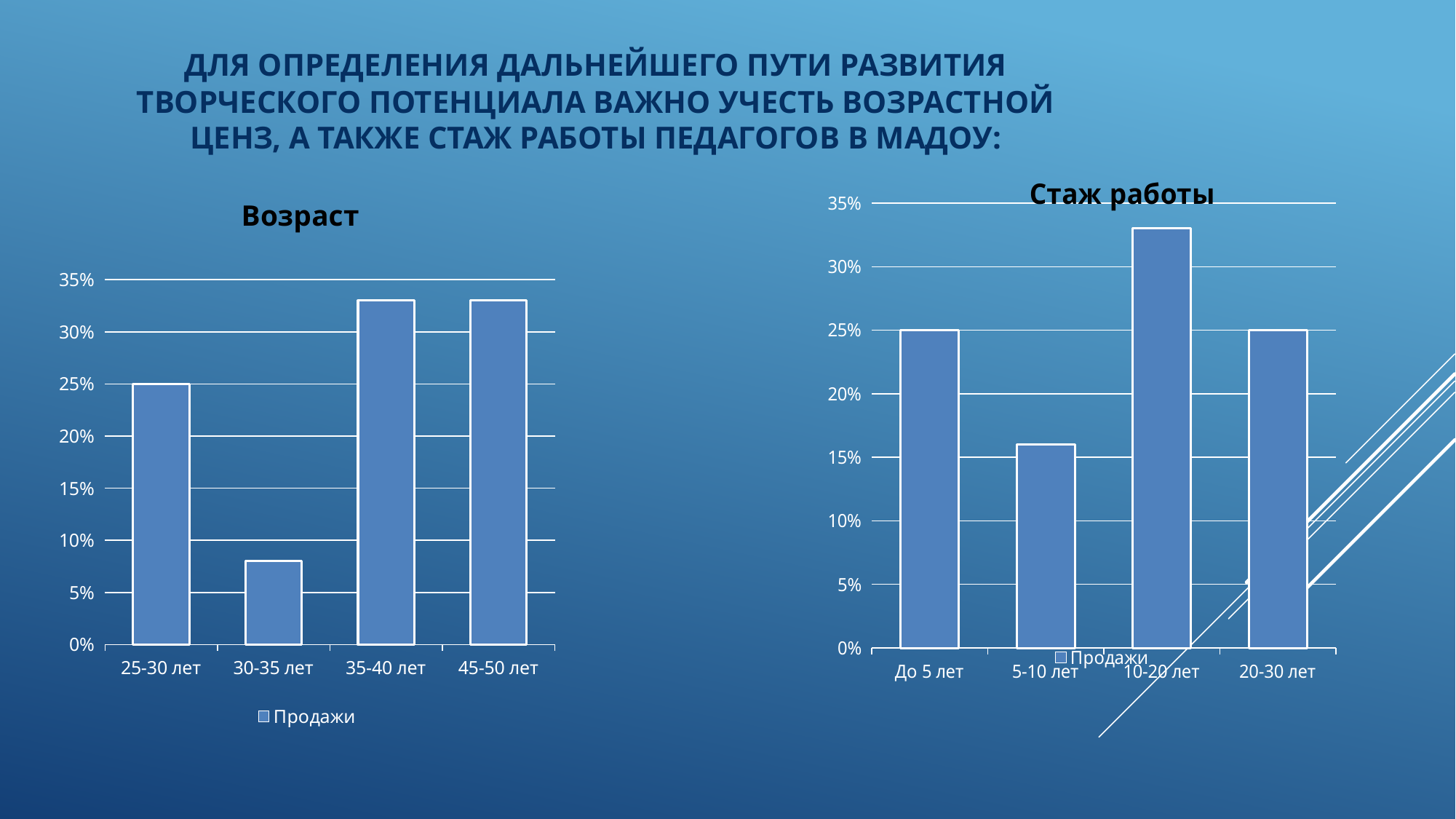
In the "Возраст" chart, how many categories are shown on the x axis? 4 In the "Возраст" chart, is the value for 35-40 лет greater or less than 30%? greater What kind of chart is the "Возраст" chart? bar chart In the "Возраст" chart, what is the value for 25-30 лет? 25% In the "Стаж работы" chart, what is the value for 20-30 лет? 25% How many series does the legend of the "Стаж работы" chart list? 1 In the "Возраст" chart, which category has the lowest value? 30-35 лет In the "Стаж работы" chart, which category has the lowest value? 5-10 лет In the "Стаж работы" chart, what is the value for До 5 лет? 25% In the "Стаж работы" chart, which category has the highest value? 10-20 лет In the "Стаж работы" chart, which is larger: the value for 10-20 лет or the value for 20-30 лет? 10-20 лет In the "Возраст" chart, is the value for 30-35 лет greater or less than 10%? less